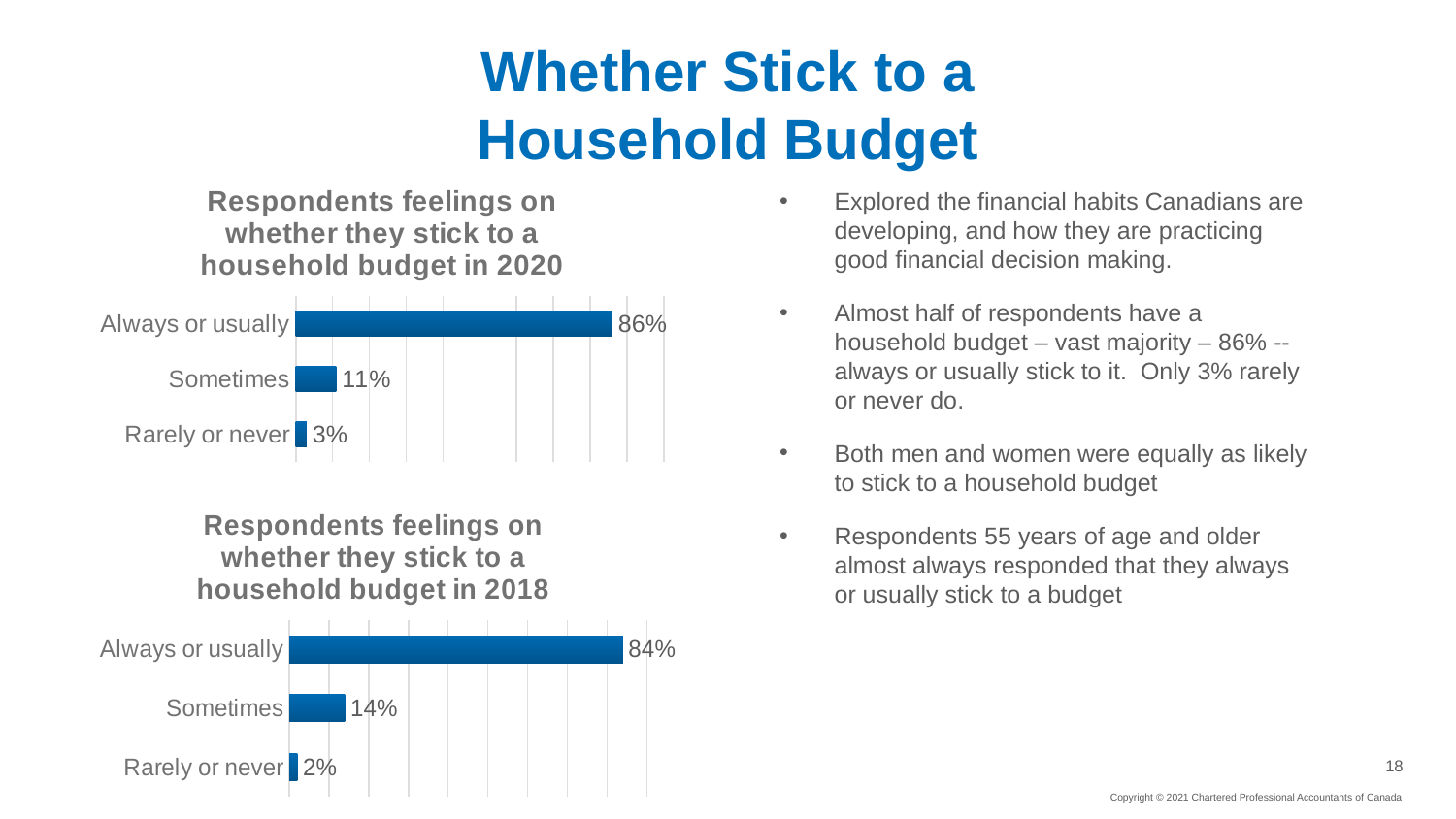
In the 2018 chart, what is the value for 'Rarely or never'? 2% What is the difference between the 'Always or usually' values in the 2020 chart and the 2018 chart? 2% In the 2020 chart, what percentage of respondents said they always or usually stick to a household budget? 86% What type of chart is the 2020 chart? Bar chart In the 2018 chart, which category has the lowest value? Rarely or never In the 2018 chart, what percentage of respondents said they sometimes stick to a household budget? 14% How many categories are shown in the 2018 chart? 3 What is the title of the top chart? Respondents feelings on whether they stick to a household budget in 2020 Which is larger: the 'Sometimes' value in the 2020 chart or the 'Sometimes' value in the 2018 chart? 2018 chart (14%) In the 2020 chart, what is the value for 'Rarely or never'? 3% In the 2020 chart, what is the difference between 'Always or usually' and 'Sometimes'? 75% In the 2020 chart, which category has the highest value? Always or usually